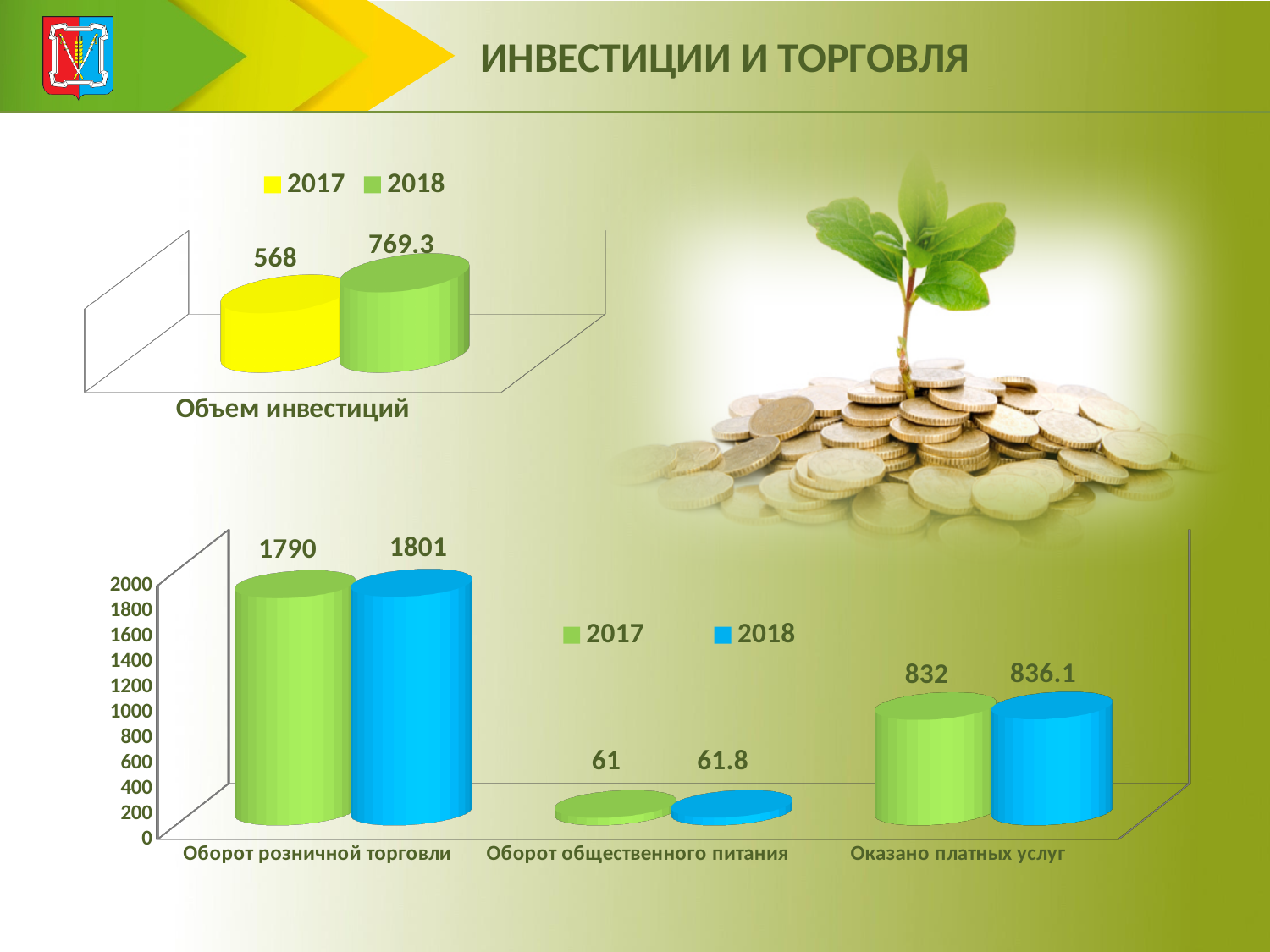
In the bottom chart, which category has the highest values? Оборот розничной торговли In the bottom chart, what is the 2018 value for Оказано платных услуг? 836.1 How many categories are shown on the x axis of the bottom chart? 3 In the bottom chart, what is the difference between the 2018 and 2017 values for Оборот розничной торговли? 11 In the top-left chart (Объем инвестиций), what is the difference between the 2018 and 2017 values? 201.3 In the top-left chart (Объем инвестиций), what is the value for 2018? 769.3 In the bottom chart, which category has the lowest values? Оборот общественного питания In the bottom chart, what is the 2018 value for Оборот розничной торговли? 1801 In the top-left chart (Объем инвестиций), which year has the larger value, 2017 or 2018? 2018 In the bottom chart, what is the 2017 value for Оборот общественного питания? 61 How many series does the legend of the bottom chart list? 2 In the top-left chart (Объем инвестиций), what is the value for 2017? 568